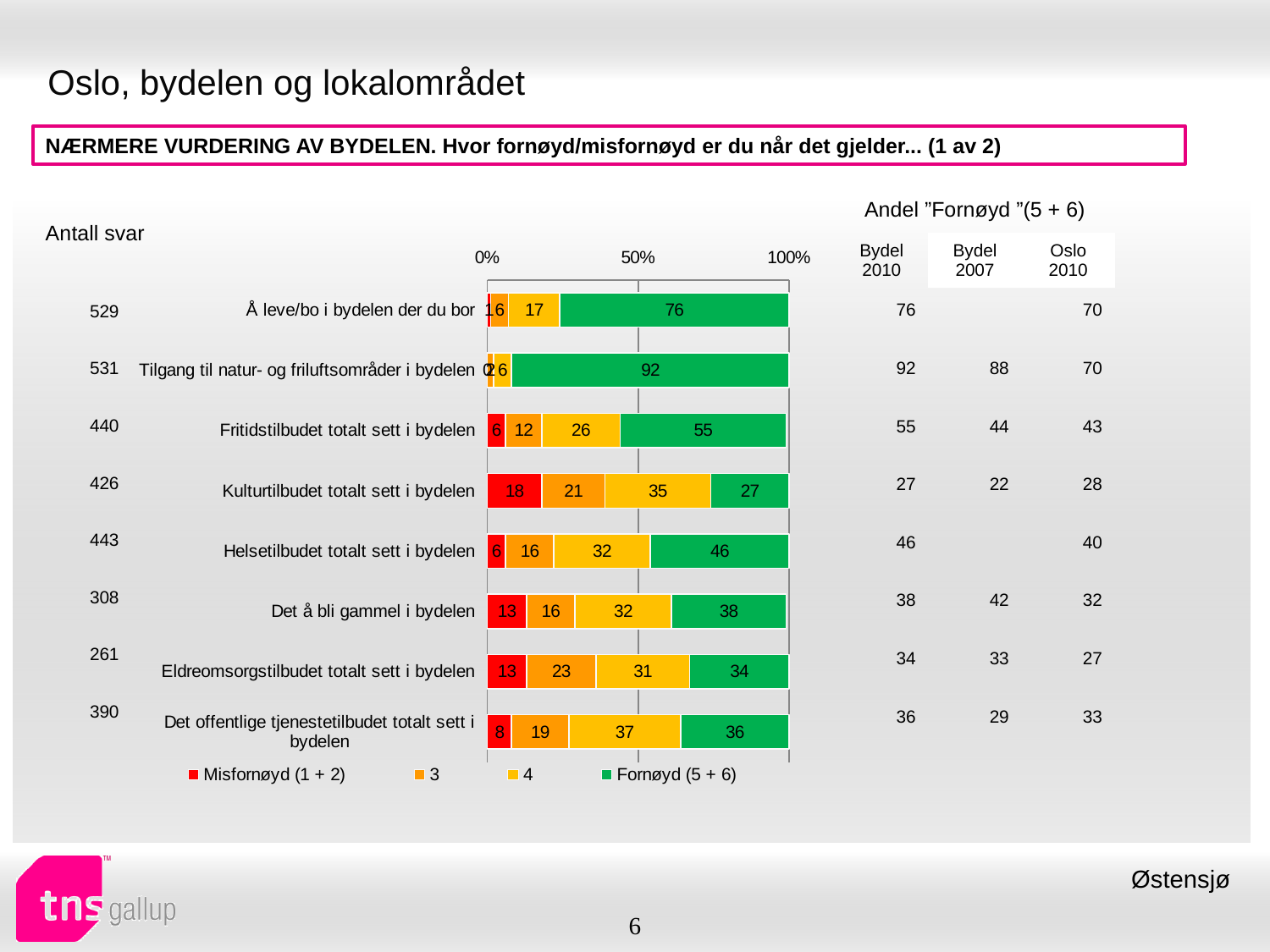
Which category has the highest value for the Fornøyd (5 + 6) series? Tilgang til natur- og friluftsområder i bydelen What kind of chart is shown on the slide? Stacked bar chart Which is larger: the Fornøyd (5 + 6) value for "Det å bli gammel i bydelen" or for "Eldreomsorgstilbudet totalt sett i bydelen"? Det å bli gammel i bydelen What is the difference between the Fornøyd (5 + 6) values for "Fritidstilbudet totalt sett i bydelen" and "Helsetilbudet totalt sett i bydelen"? 9 What is the value of the Misfornøyd (1 + 2) series for "Kulturtilbudet totalt sett i bydelen"? 18 What is the value of the Fornøyd (5 + 6) series for "Tilgang til natur- og friluftsområder i bydelen"? 92 How many categories are shown in the bar chart? 8 How many series does the chart legend list? 4 What is the value of series 4 for "Det offentlige tjenestetilbudet totalt sett i bydelen"? 37 What is the total of the stacked bar for "Helsetilbudet totalt sett i bydelen"? 100 What is the value of series 3 for "Eldreomsorgstilbudet totalt sett i bydelen"? 23 Which category has the lowest value for the Fornøyd (5 + 6) series? Kulturtilbudet totalt sett i bydelen